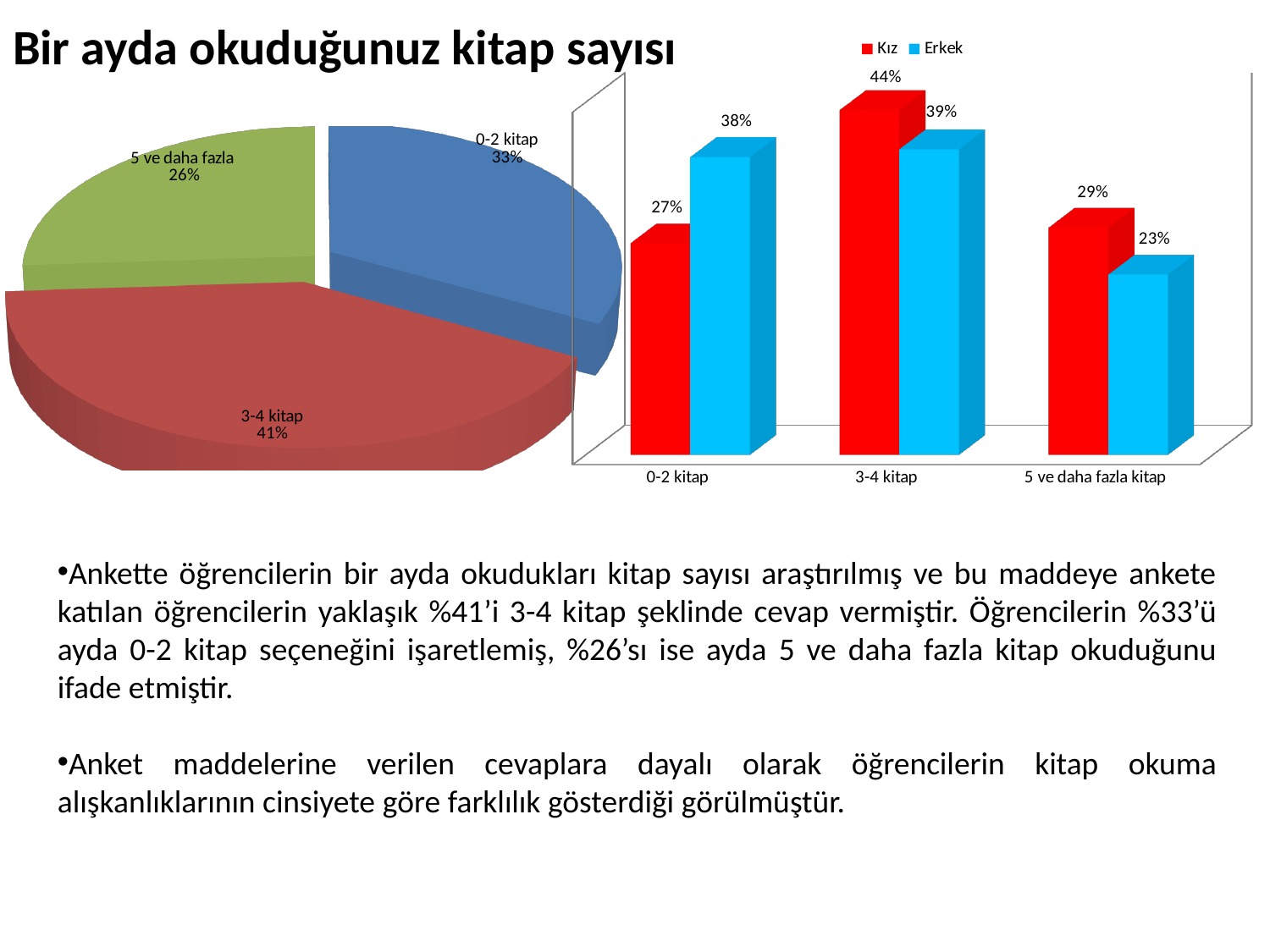
In the pie chart on the left, what share is shown for 5 ve daha fazla? 26% In the pie chart on the left, which category has the largest slice? 3-4 kitap In the bar chart on the right, what is the value for Kız in the 0-2 kitap category? 27% In the pie chart on the left, how many slices are there? 3 In the bar chart on the right, what is the value for Erkek in the 3-4 kitap category? 39% In the bar chart on the right, which is larger for 5 ve daha fazla kitap, Kız or Erkek? Kız In the pie chart on the left, which category has the smallest slice? 5 ve daha fazla In the bar chart on the right, what is the difference between the Erkek and Kız values for 0-2 kitap? 11% In the bar chart on the right, what is the value for Erkek in the 5 ve daha fazla kitap category? 23% In the bar chart on the right, how many series does the legend list? 2 In the pie chart on the left, what share is shown for 3-4 kitap? 41% In the bar chart on the right, which category has the highest Kız value? 3-4 kitap